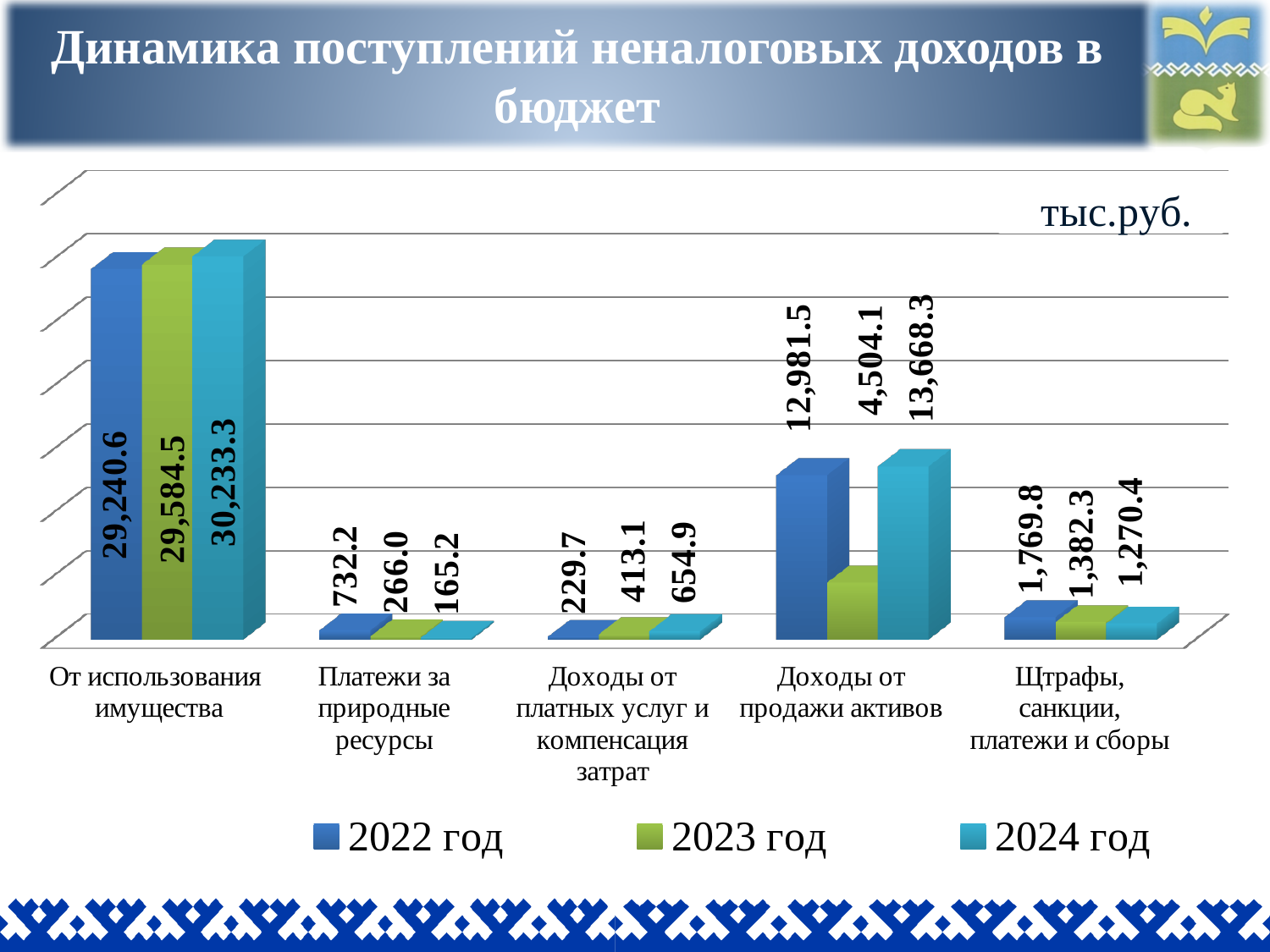
Which category has the lowest value for 2022 год? Доходы от платных услуг и компенсация затрат How many series does the legend list? 3 What is the value for 2022 год in the category «Платежи за природные ресурсы»? 732.2 What is the difference between the 2024 год and 2022 год values for «От использования имущества»? 992.7 Which is larger for «Доходы от продажи активов»: the 2022 год value or the 2023 год value? 2022 год What kind of chart is shown on the slide? Bar chart Which category has the highest value for 2024 год? От использования имущества What is the difference between the 2022 год and 2024 год values for «Платежи за природные ресурсы»? 567.0 How many categories are shown on the x axis? 5 Do the values for «Доходы от платных услуг и компенсация затрат» rise or fall from 2022 год to 2024 год? Rise What is the value for 2024 год in the category «Доходы от продажи активов»? 13,668.3 What is the value for 2023 год in the category «Штрафы, санкции, платежи и сборы»? 1,382.3